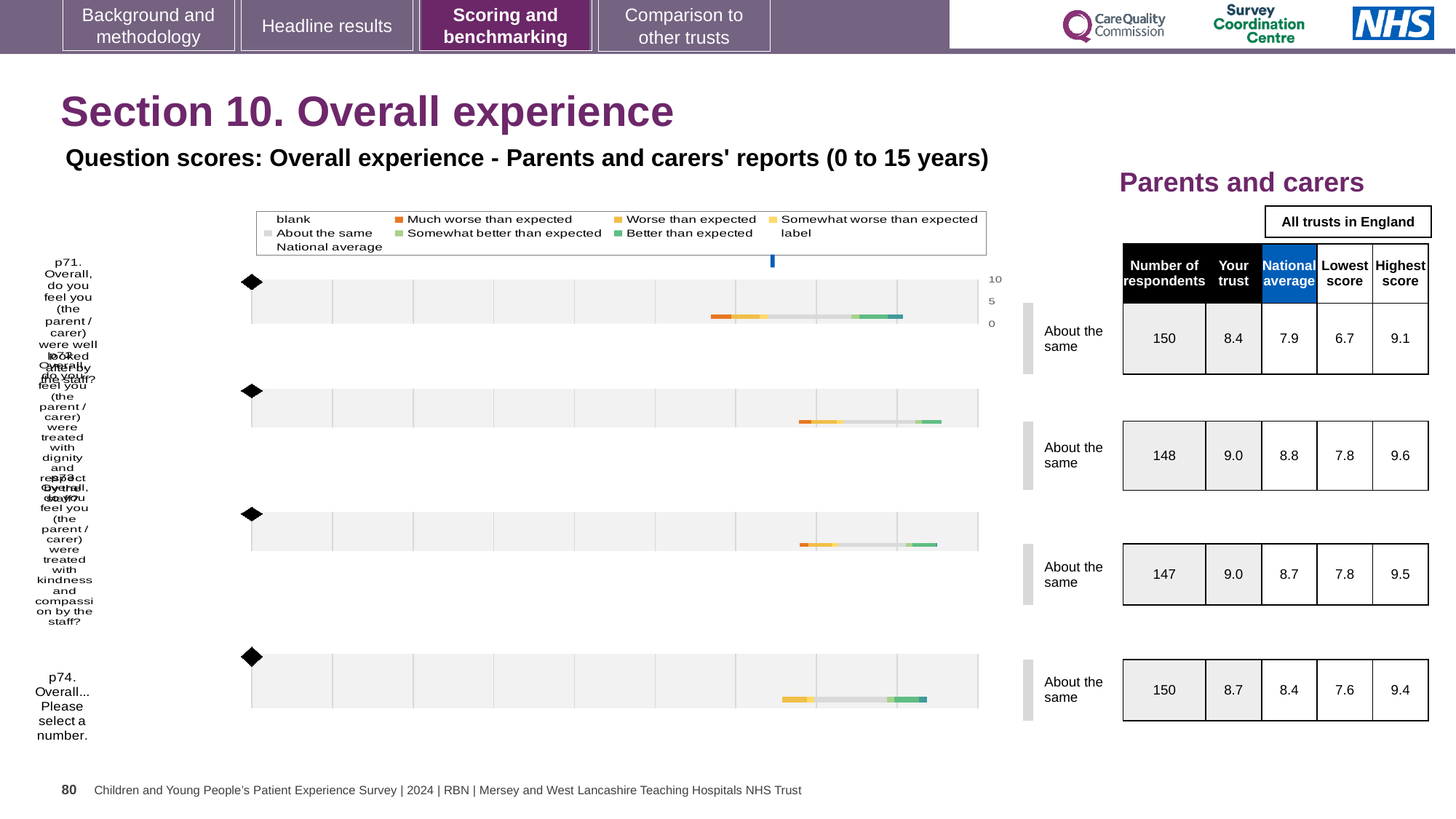
What benchmark label is shown next to the bar for p74 'Overall... Please select a number'? About the same What kind of chart is used to show the question scores on this slide? bar chart How many question rows (bar charts) are shown on the slide? 4 In the table beside the charts, how many respondents are listed for the bottom row (p74)? 150 In the table beside the charts, what is the Highest score for the bottom row (p74)? 9.4 In the legend, what colour represents 'Better than expected'? green For the bottom row (p74), what is the difference between the 'Your trust' score and the National average? 0.3 For the bottom row (p74), which is larger: the 'Your trust' score or the National average? Your trust How many entries does the legend above the charts list? 9 In the table beside the charts, what is the 'Your trust' score for the bottom row (p74)? 8.7 In the table beside the charts, what is the National average for the bottom row (p74)? 8.4 In the legend, what colour represents 'Much worse than expected'? orange